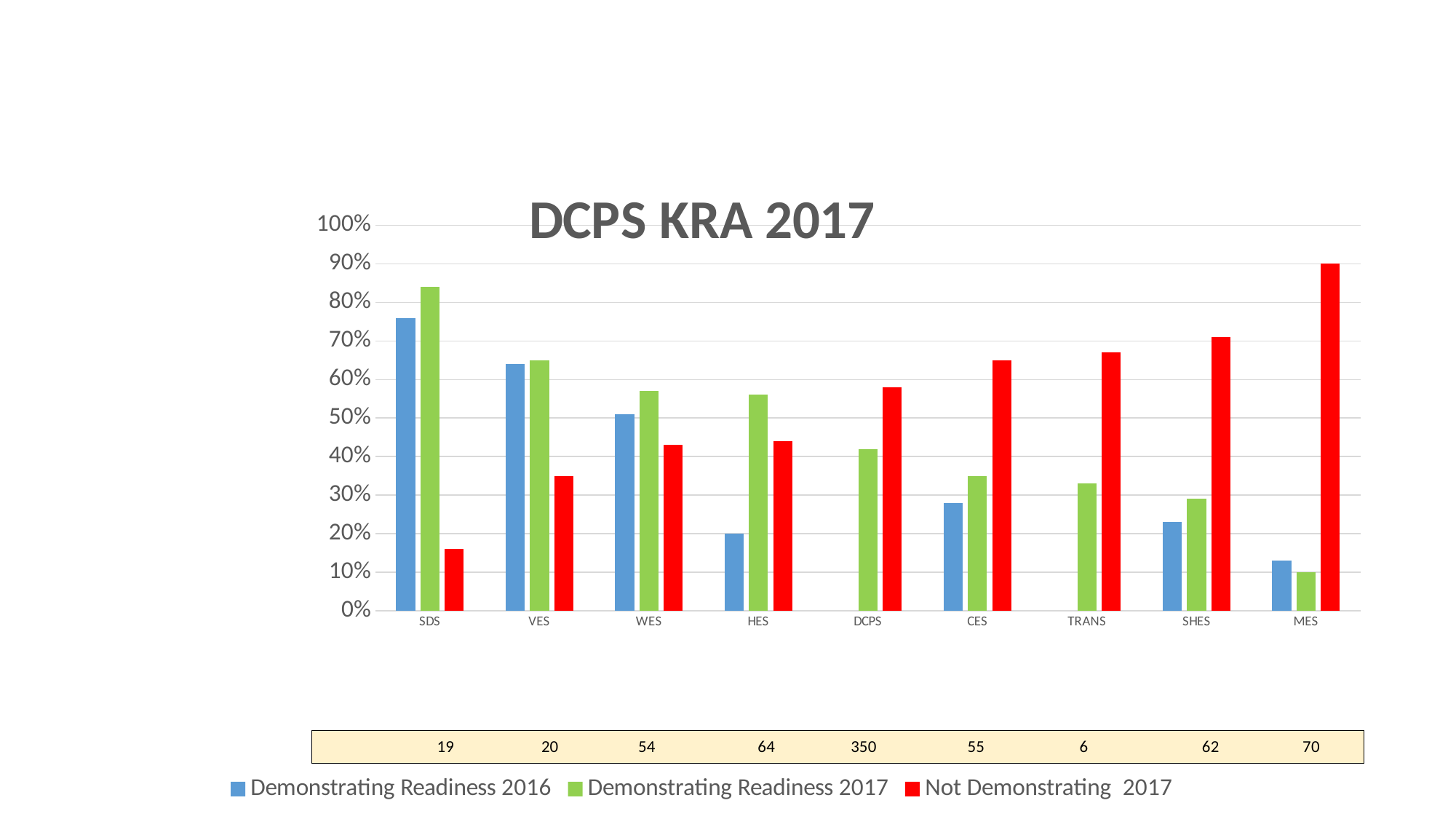
How many categories are shown along the x axis? 9 How many series does the legend list? 3 Is the Demonstrating Readiness 2016 value for MES greater or less than 20%? less What type of chart is shown on the slide? bar chart Which category has the highest value for Demonstrating Readiness 2017? SDS What is the title of the chart? DCPS KRA 2017 What is the Not Demonstrating 2017 value for MES? 90% Which category has the lowest value for Not Demonstrating 2017? SDS Which category has the highest value for Not Demonstrating 2017? MES Is the Demonstrating Readiness 2017 value for SDS greater or less than 80%? greater For CES, which is larger: Demonstrating Readiness 2017 or Not Demonstrating 2017? Not Demonstrating 2017 What colour represents the Not Demonstrating 2017 series? red